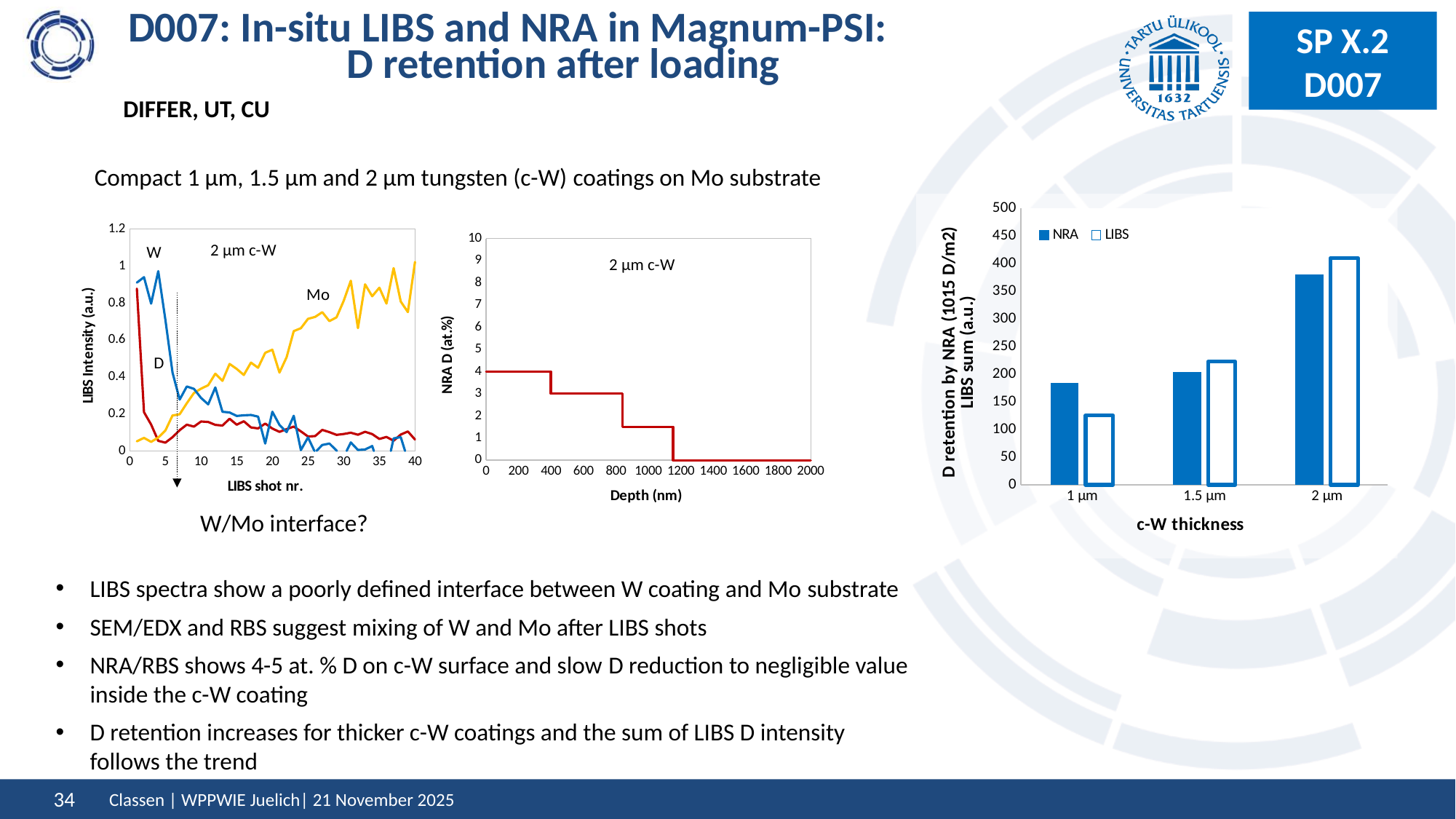
In the middle chart of NRA D versus depth, what is the NRA D value (at.%) at a depth of 200 nm? 4 In the bar chart on the right, which c-W thickness has the highest NRA value? 2 µm In the bar chart on the right, do the NRA values rise or fall as c-W thickness increases from 1 µm to 2 µm? rise In the bar chart on the right, which c-W thickness has the lowest LIBS value? 1 µm In the bar chart on the right, is the LIBS value for 1 µm greater or less than 150? less In the bar chart on the right, is the NRA value for 2 µm greater or less than 350? greater In the middle chart of NRA D versus depth, does the NRA D value rise or fall as depth increases? fall What kind of chart is the chart on the right of the slide, plotting D retention against c-W thickness? bar chart In the bar chart on the right, how many series does the legend list? 2 In the bar chart on the right, which is larger at 1 µm, the NRA bar or the LIBS bar? NRA In the left chart of LIBS intensity versus LIBS shot nr., which element's line rises with increasing shot number, W or Mo? Mo In the bar chart on the right, how many c-W thickness categories are shown on the x axis? 3